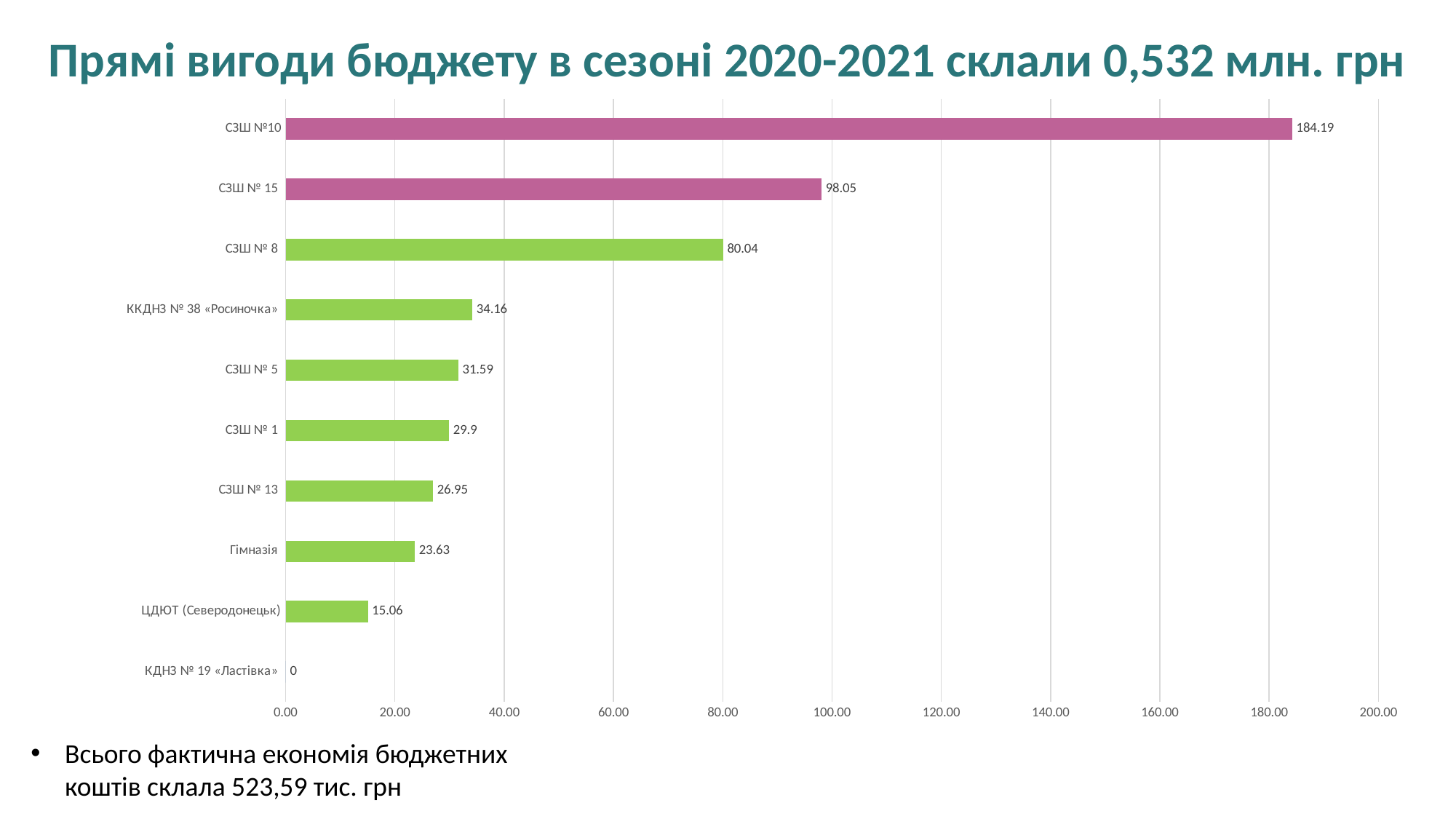
What is the difference between the values for СЗШ №10 and СЗШ № 15? 86.14 What is the value for ЦДЮТ (Северодонецьк)? 15.06 What is the difference between the values for СЗШ № 8 and Гімназія? 56.41 What is the value for СЗШ №10? 184.19 Which category has the highest value? СЗШ №10 What kind of chart is shown on the slide? bar chart How many categories are shown on the chart? 10 How many bars are coloured pink/magenta rather than green? 2 Which is larger, the value for СЗШ № 5 or the value for СЗШ № 1? СЗШ № 5 Which category has the lowest value? КДНЗ № 19 «Ластівка» What is the value for ККДНЗ № 38 «Росиночка»? 34.16 Is the value for СЗШ № 15 greater or less than 100? less